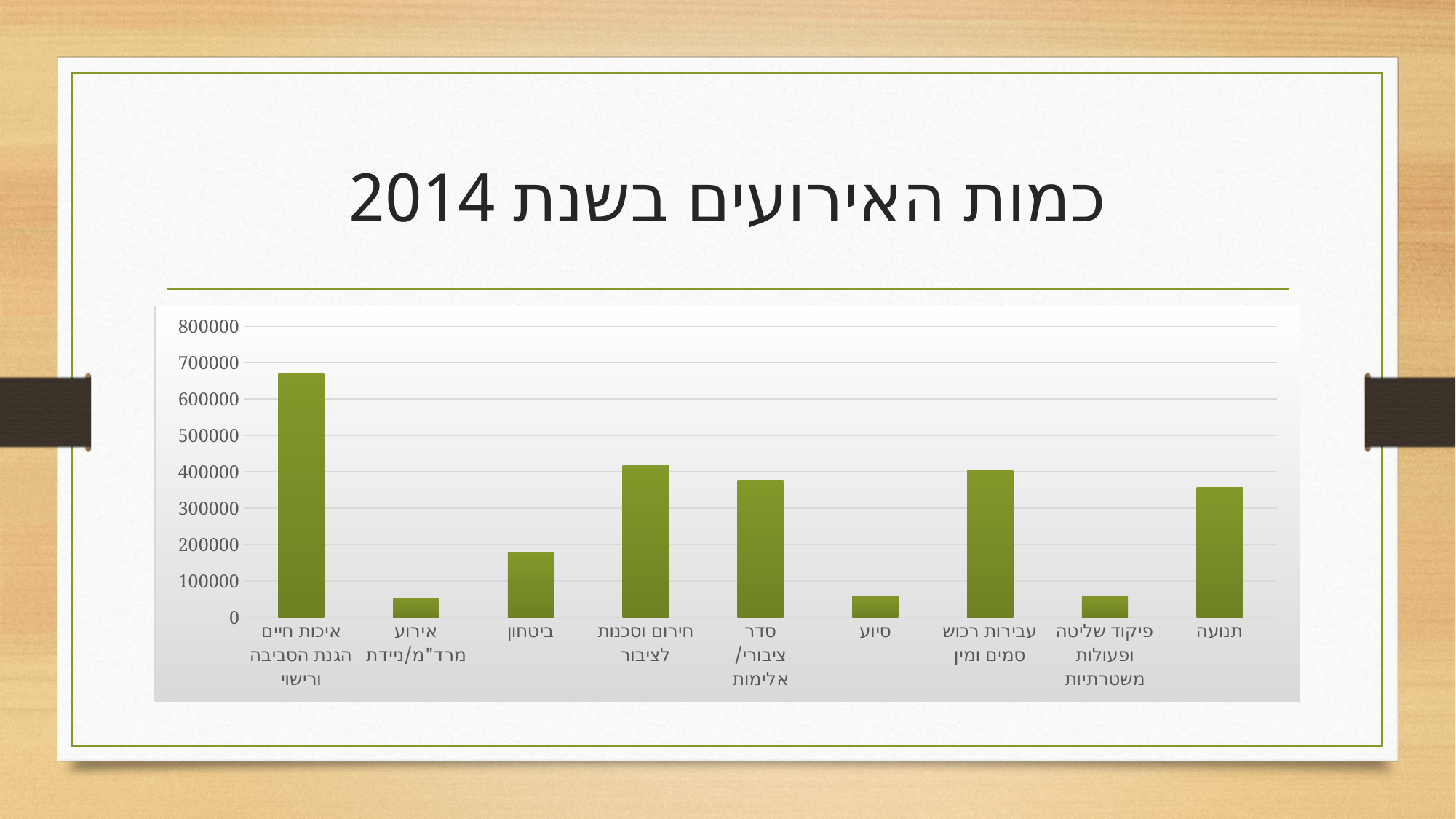
Is the value for תנועה greater or less than 300000? greater Which is larger, the value for ביטחון or the value for תנועה? תנועה Is the value for סדר ציבורי/אלימות greater or less than 400000? less What is the title of the chart? כמות האירועים בשנת 2014 How many categories are shown on the x axis of the chart? 9 What colour are the bars in the chart? green Which category has the highest value in the chart? איכות חיים הגנת הסביבה ורישוי What kind of chart is shown on the slide? bar chart Which is larger, the value for חירום וסכנות לציבור or the value for סדר ציבורי/אלימות? חירום וסכנות לציבור Is the value for איכות חיים הגנת הסביבה ורישוי greater or less than 600000? greater